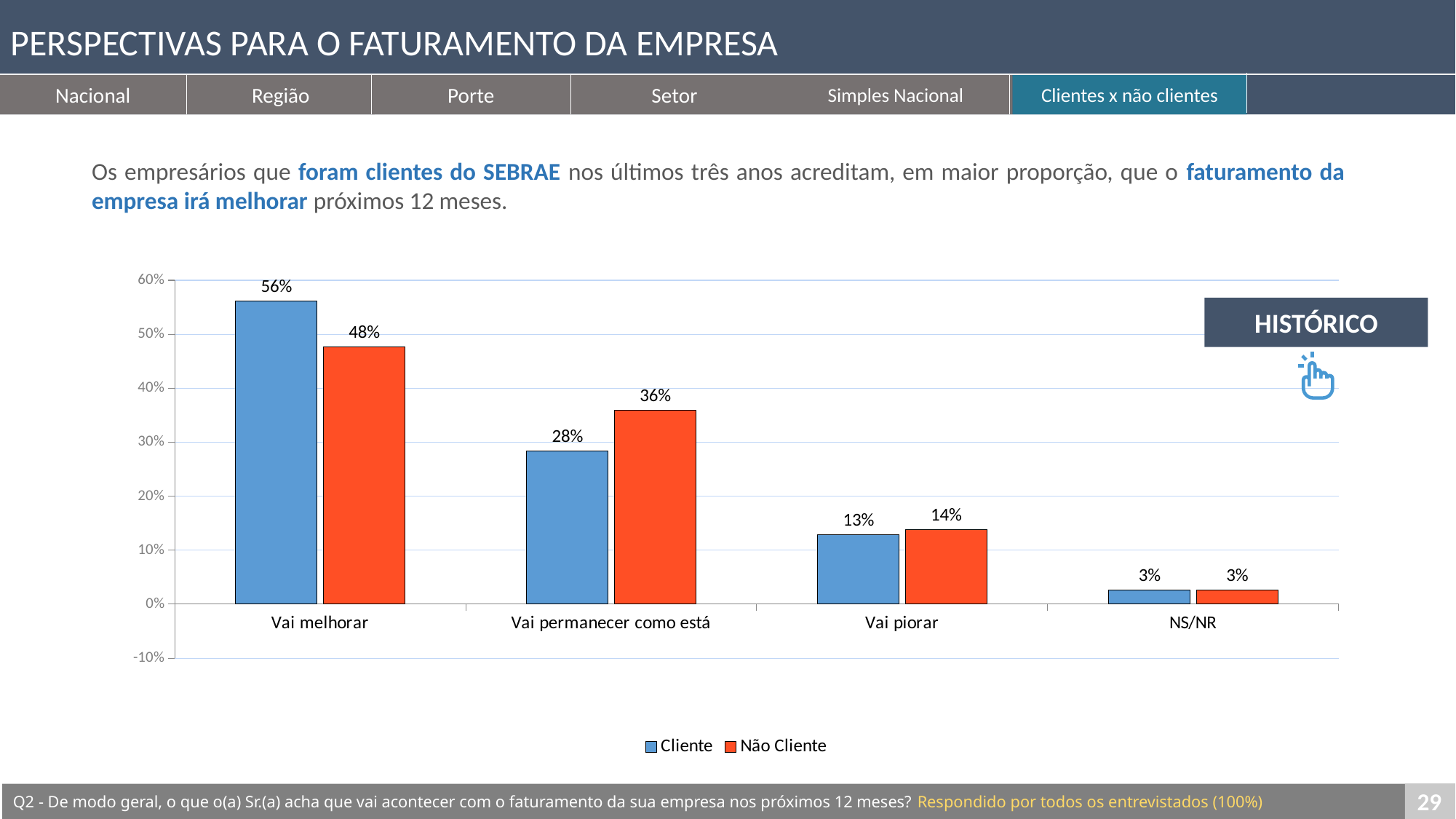
Is the value for Cliente in 'Vai melhorar' greater or less than 50%? greater Which category has the highest value for Não Cliente? Vai melhorar What kind of chart is shown on the slide? Bar chart Which category has the lowest value for Cliente? NS/NR How many series does the legend list? 2 What is the difference between Cliente and Não Cliente in the 'Vai melhorar' category? 8% Which colour represents the Não Cliente series? Orange What is the value for Cliente in the 'Vai melhorar' category? 56% What is the value for Não Cliente in the 'Vai permanecer como está' category? 36% How many categories are shown on the x axis? 4 In the 'Vai permanecer como está' category, which series has the larger value, Cliente or Não Cliente? Não Cliente What is the value for Cliente in the 'Vai piorar' category? 13%